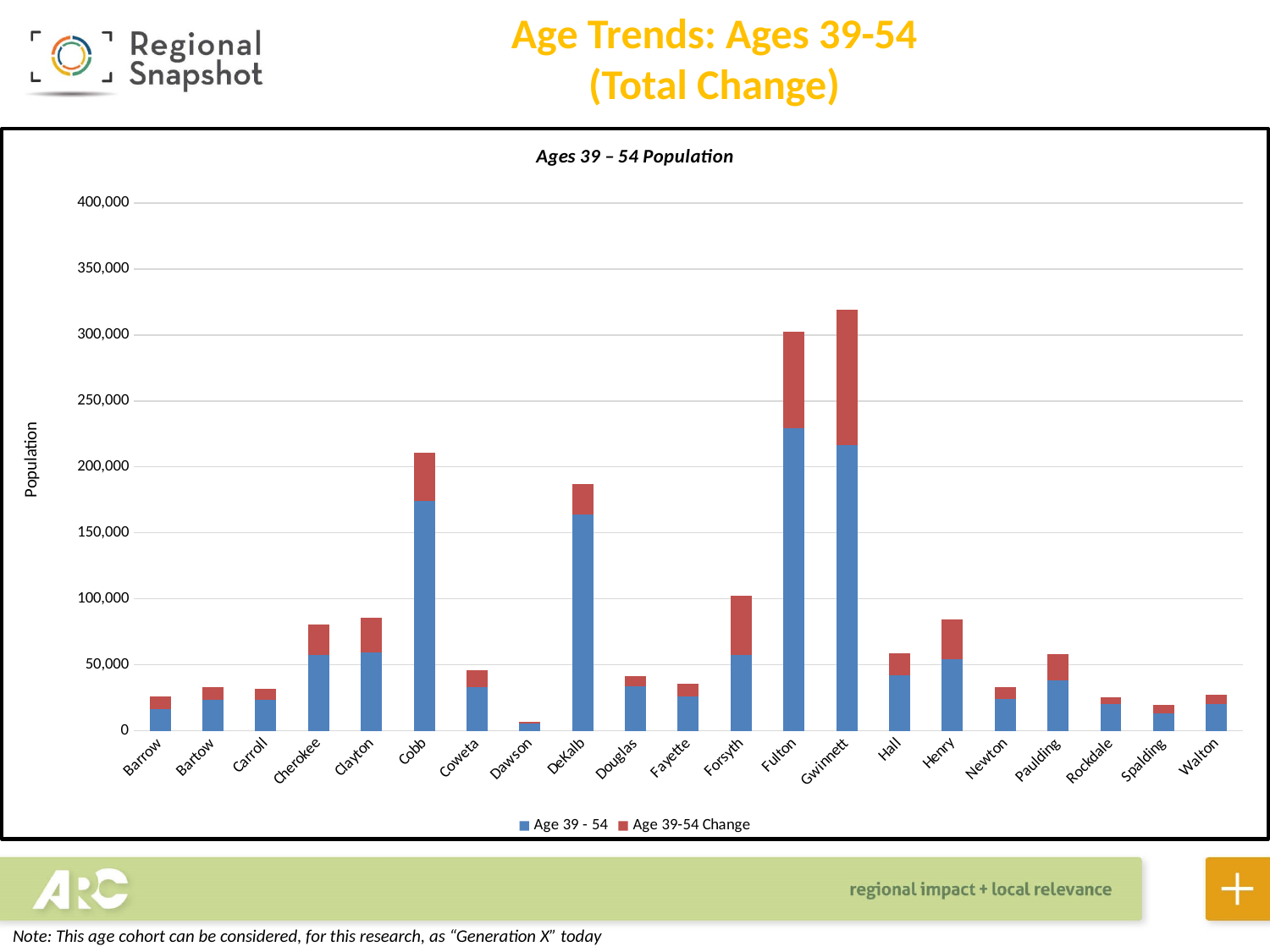
Is the total bar for Dawson greater or less than 50,000? less Which county has the larger total bar, Cobb or DeKalb? Cobb Which county has the shortest total bar in the chart? Dawson Is the total bar for Cherokee greater or less than 50,000? greater How many series does the chart's legend list? 2 What is the title of the chart? Ages 39 – 54 Population Is the total bar for Cobb greater or less than 200,000? greater What are the two series named in the chart's legend? Age 39 - 54 and Age 39-54 Change What kind of chart is shown on the slide? Stacked bar chart How many counties are shown along the x axis of the chart? 21 Which county has the tallest total bar in the chart? Gwinnett